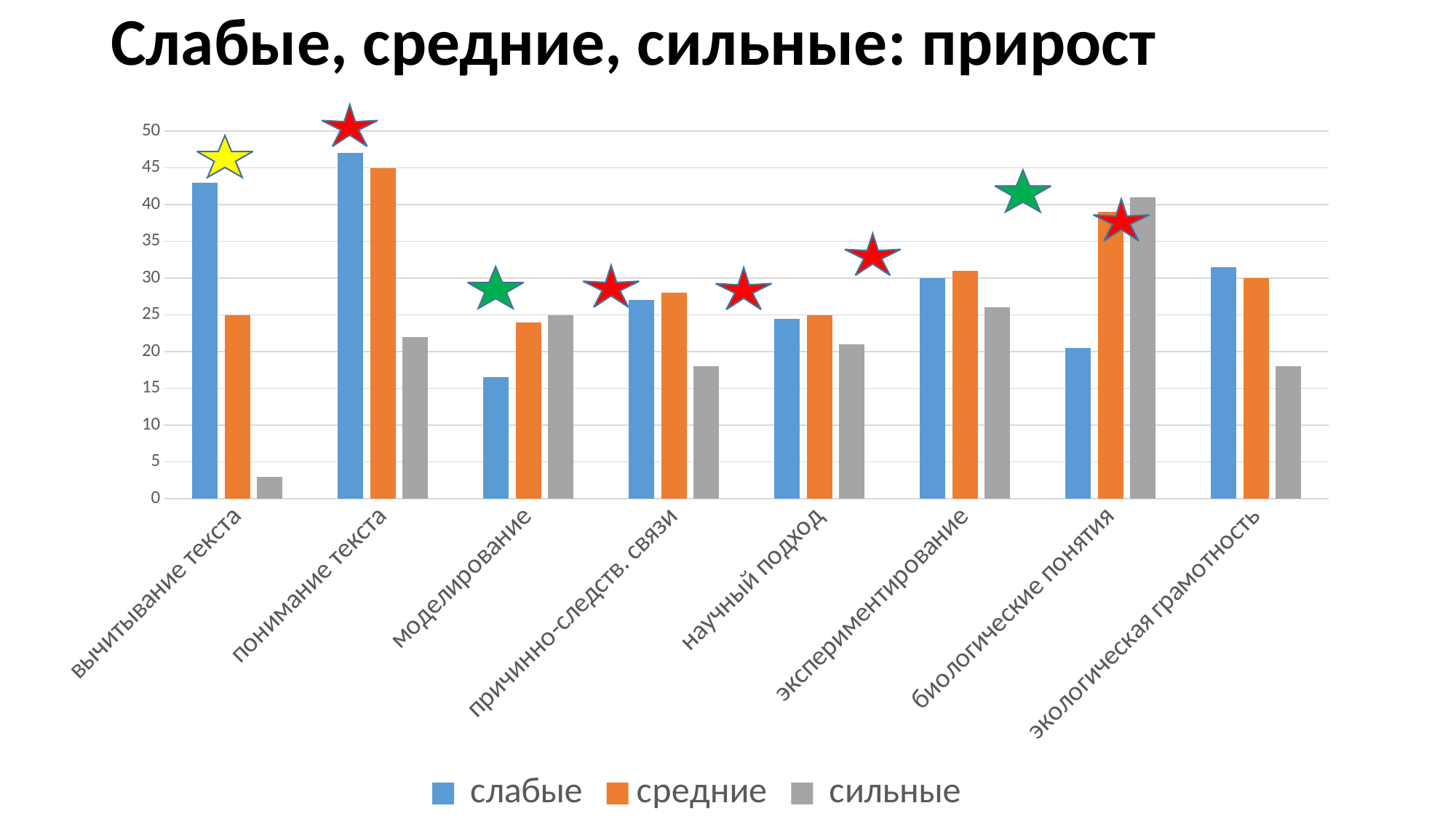
What is the title of the chart on the slide? Слабые, средние, сильные: прирост Is the 'слабые' value for 'моделирование' greater or less than 20? less How many series does the legend list? 3 What kind of chart is shown on the slide? bar chart Which category has the lowest bar for the 'сильные' series? вычитывание текста How many categories are shown on the x axis? 8 For 'биологические понятия', which is larger: the 'слабые' value or the 'сильные' value? сильные Which category has the highest bar for the 'сильные' series? биологические понятия For 'вычитывание текста', which is larger: the 'слабые' value or the 'средние' value? слабые Is the 'сильные' value for 'биологические понятия' greater or less than 35? greater Is the 'слабые' value for 'понимание текста' greater or less than 45? greater Which category has the highest bar for the 'слабые' series? понимание текста